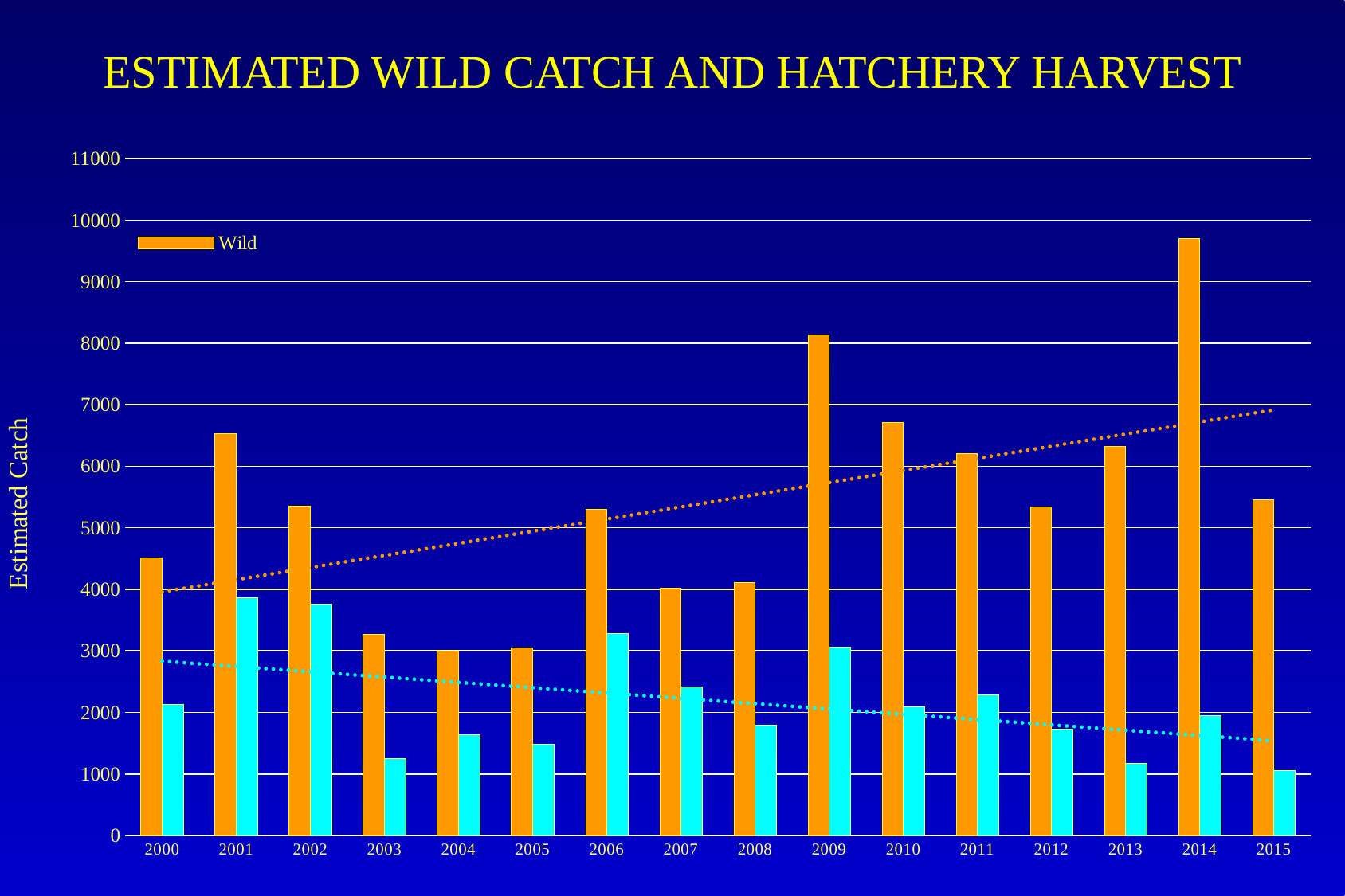
How many years are shown along the x axis? 16 Is the Wild value for 2014 greater or less than 9000? greater Is the Wild value for 2003 greater or less than 4000? less What is the label on the y axis? Estimated Catch Which year has the highest Wild value? 2014 Which is larger, the Wild value for 2009 or for 2010? 2009 What kind of chart is shown on the slide? bar chart Which is larger, the Wild value for 2001 or for 2002? 2001 What is the title of the chart? ESTIMATED WILD CATCH AND HATCHERY HARVEST Is the Wild value for 2009 greater or less than 8000? greater Does the dotted orange trend line for Wild rise or fall from 2000 to 2015? rise